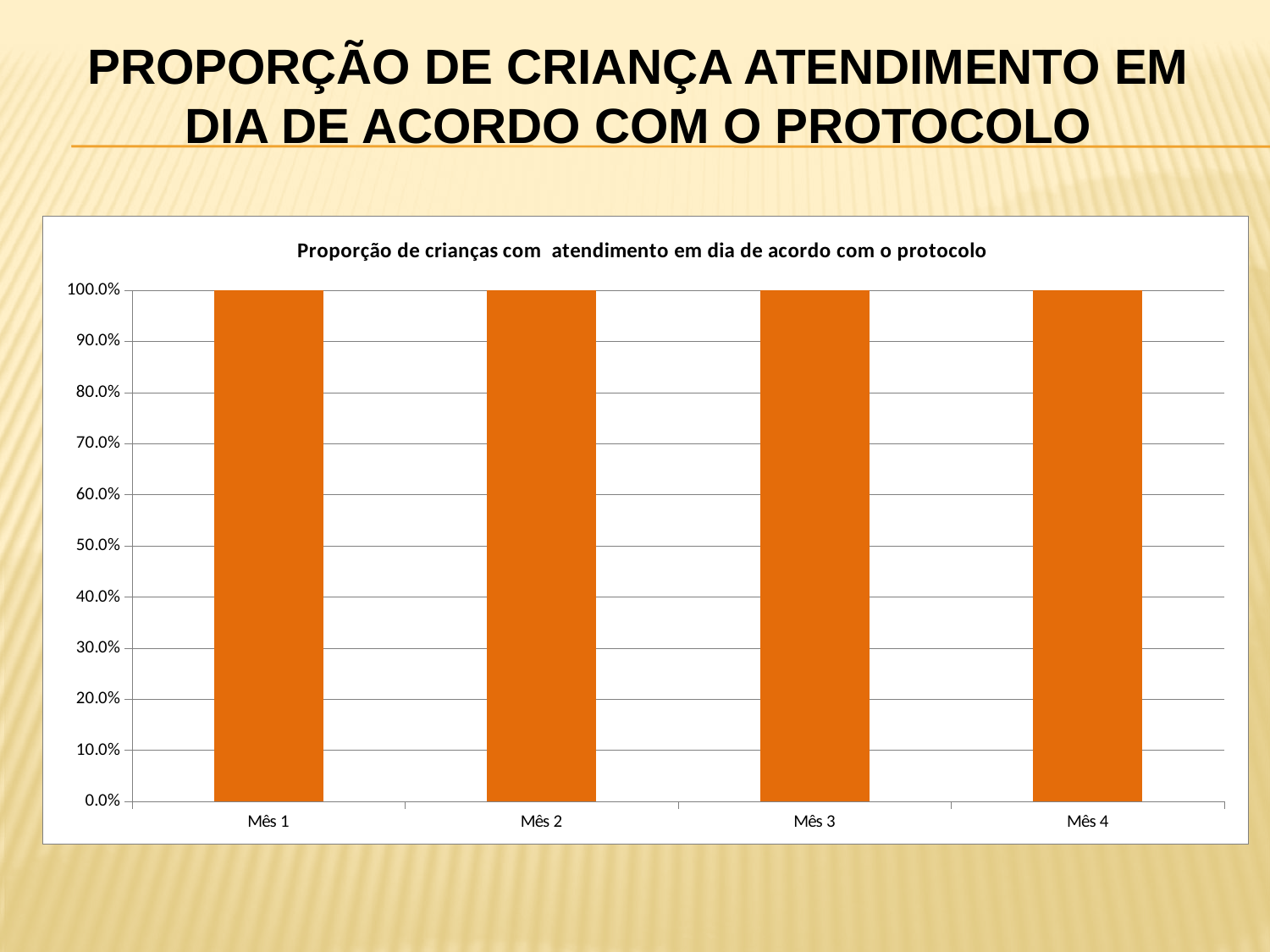
What is the difference between the values for Mês 1 and Mês 3? 0.0% How many categories are shown on the x axis? 4 Do the values rise, fall, or stay flat from Mês 1 to Mês 4? stay flat What is the title of the chart? Proporção de crianças com atendimento em dia de acordo com o protocolo What is the value for Mês 1? 100.0% What colour are the bars in the chart? orange What is the value for Mês 3? 100.0% Is the value for Mês 2 greater or less than 90.0%? greater What is the value for Mês 2? 100.0% What kind of chart is shown on the slide? bar chart Is the value for Mês 4 greater or less than 50.0%? greater What is the value for Mês 4? 100.0%